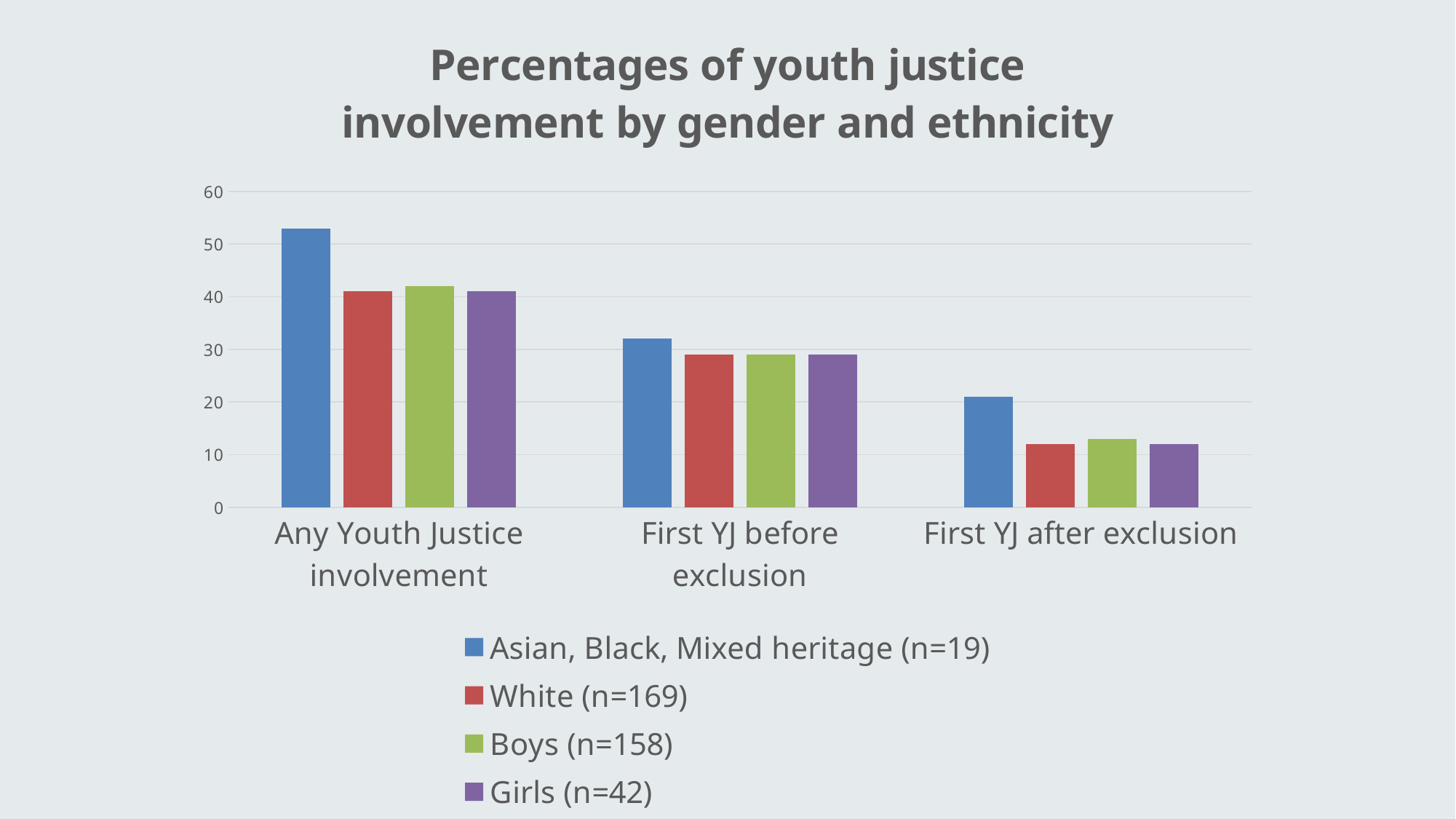
How many series does the legend list? 4 Which series has the highest value for First YJ after exclusion? Asian, Black, Mixed heritage (n=19) Is the value for Girls (n=42) for First YJ before exclusion greater or less than 20? greater Do the values for Asian, Black, Mixed heritage (n=19) rise or fall from left to right across the categories? fall Which series has the highest value for Any Youth Justice involvement? Asian, Black, Mixed heritage (n=19) Is the value for White (n=169) for First YJ after exclusion greater or less than 20? less What kind of chart is shown on the slide? bar chart How many categories are shown on the x axis? 3 What is the title of the chart? Percentages of youth justice involvement by gender and ethnicity Is the value for Asian, Black, Mixed heritage (n=19) for Any Youth Justice involvement greater or less than 50? greater For Any Youth Justice involvement, which is larger: the value for Asian, Black, Mixed heritage (n=19) or the value for White (n=169)? Asian, Black, Mixed heritage (n=19)